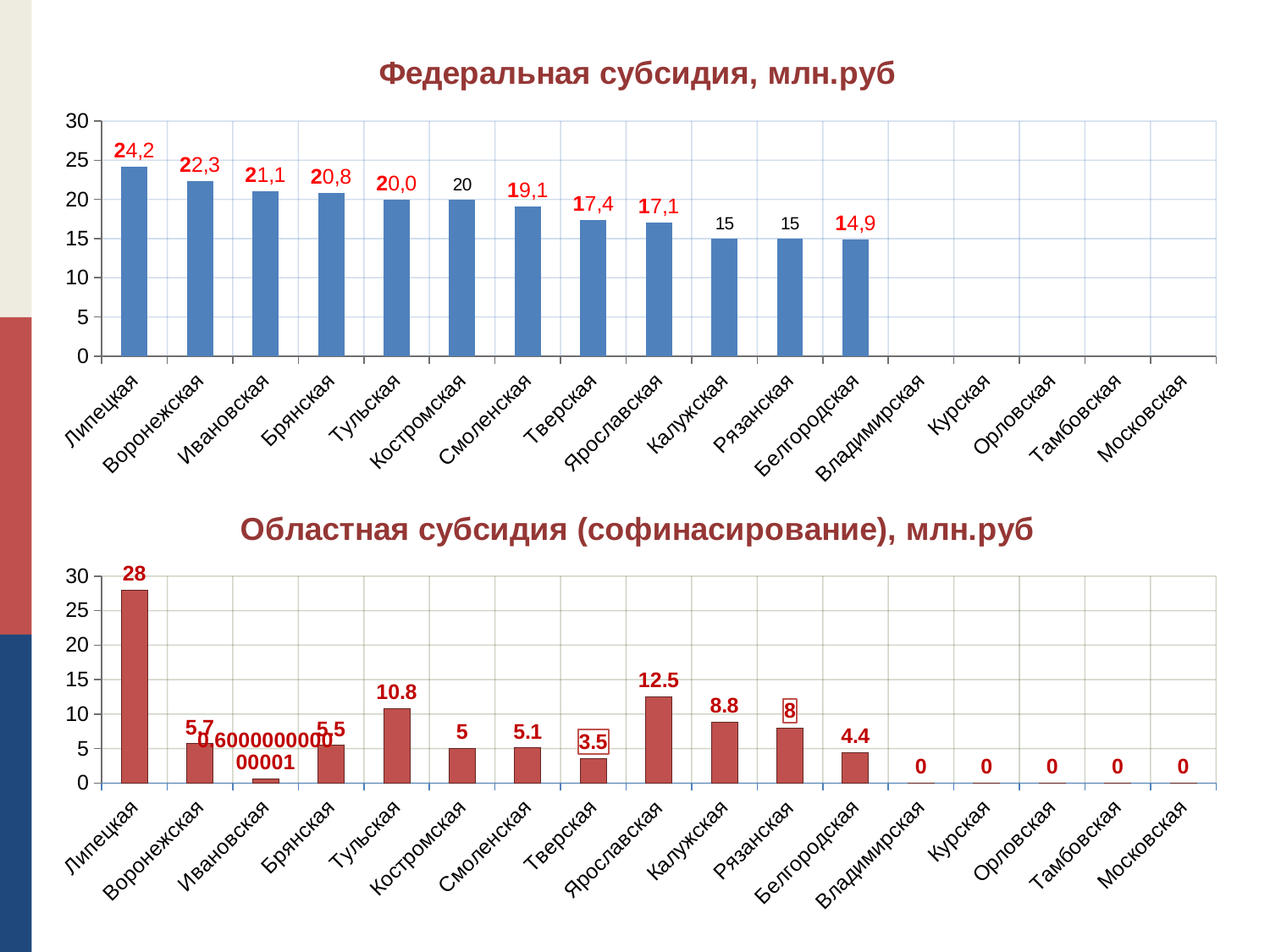
In the chart titled "Областная субсидия (софинасирование), млн.руб", which is larger, the value for Рязанская or the value for Белгородская? Рязанская In the chart titled "Областная субсидия (софинасирование), млн.руб", what is the value for Ярославская? 12.5 In the chart titled "Федеральная субсидия, млн.руб", what is the value for Липецкая? 24,2 What kind of chart is the chart titled "Федеральная субсидия, млн.руб"? Bar chart In the chart titled "Федеральная субсидия, млн.руб", which is larger, the value for Брянская or the value for Смоленская? Брянская In the chart titled "Областная субсидия (софинасирование), млн.руб", which region has the highest value? Липецкая How many regions are listed on the x axis of the chart titled "Областная субсидия (софинасирование), млн.руб"? 17 In the chart titled "Областная субсидия (софинасирование), млн.руб", what is the difference between the values for Тульская and Тверская? 7.3 In the chart titled "Федеральная субсидия, млн.руб", which region has the highest value? Липецкая In the chart titled "Федеральная субсидия, млн.руб", what is the value for Тверская? 17,4 In the chart titled "Областная субсидия (софинасирование), млн.руб", what is the value for Калужская? 8.8 In the chart titled "Федеральная субсидия, млн.руб", what is the difference between the values for Воронежская and Белгородская? 7,4